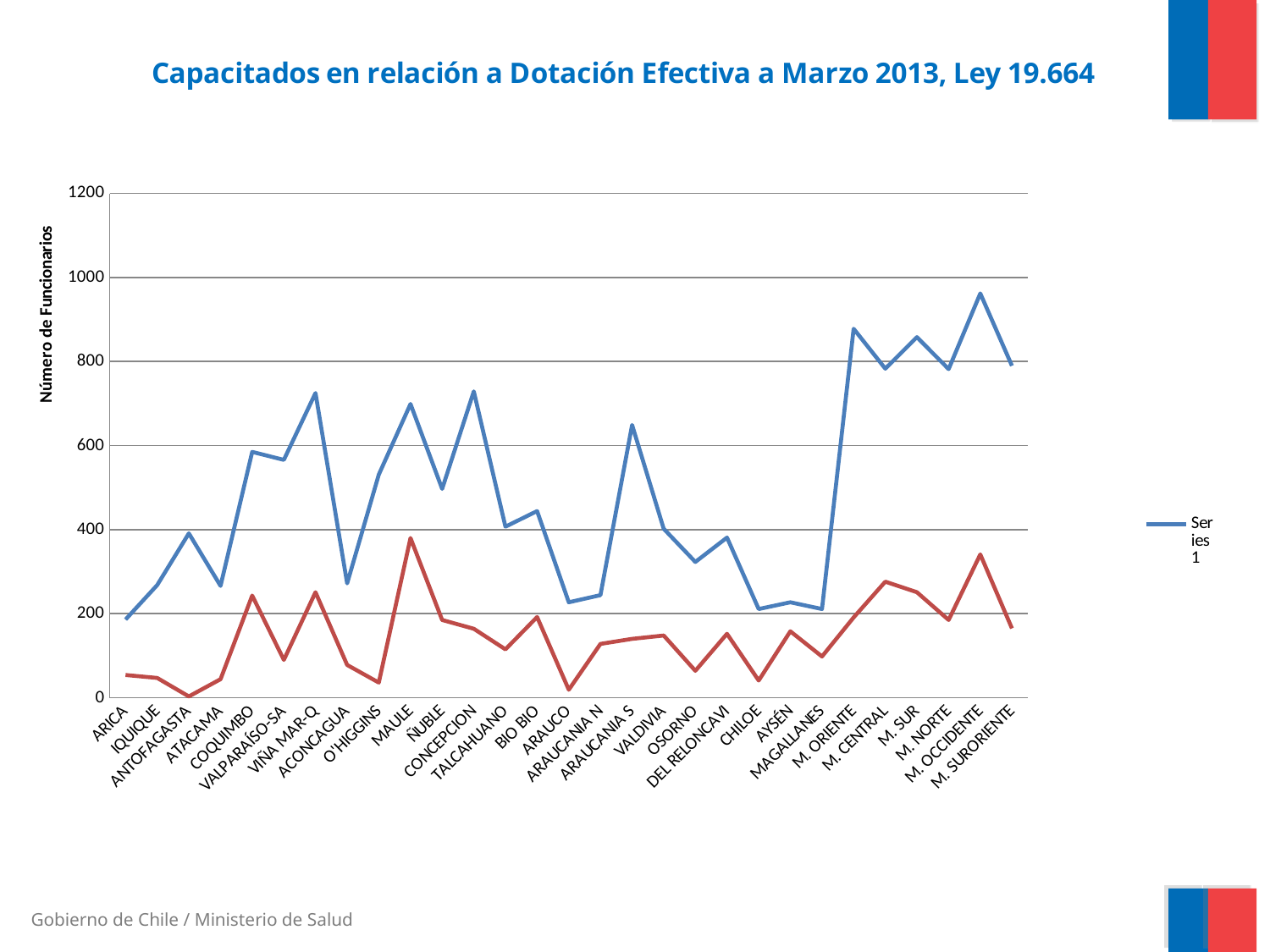
Is the blue line's value for COQUIMBO greater or less than 400? greater How many series does the chart's legend list? 1 What is the label on the vertical axis of the chart? Número de Funcionarios How many categories are shown along the x axis of the chart? 29 On the red line, which is larger: the value for MAULE or the value for ÑUBLE? MAULE For the red line, which category has the highest value? MAULE Is the red line's value for ANTOFAGASTA greater or less than 200? less Is the blue line's value for M. OCCIDENTE greater or less than 800? greater What is the title shown above the chart? Capacitados en relación a Dotación Efectiva a Marzo 2013, Ley 19.664 For the blue line, which category has the highest value? M. OCCIDENTE What kind of chart is shown on the slide? line chart On the blue line, which is larger: the value for VIÑA MAR-Q or the value for ACONCAGUA? VIÑA MAR-Q